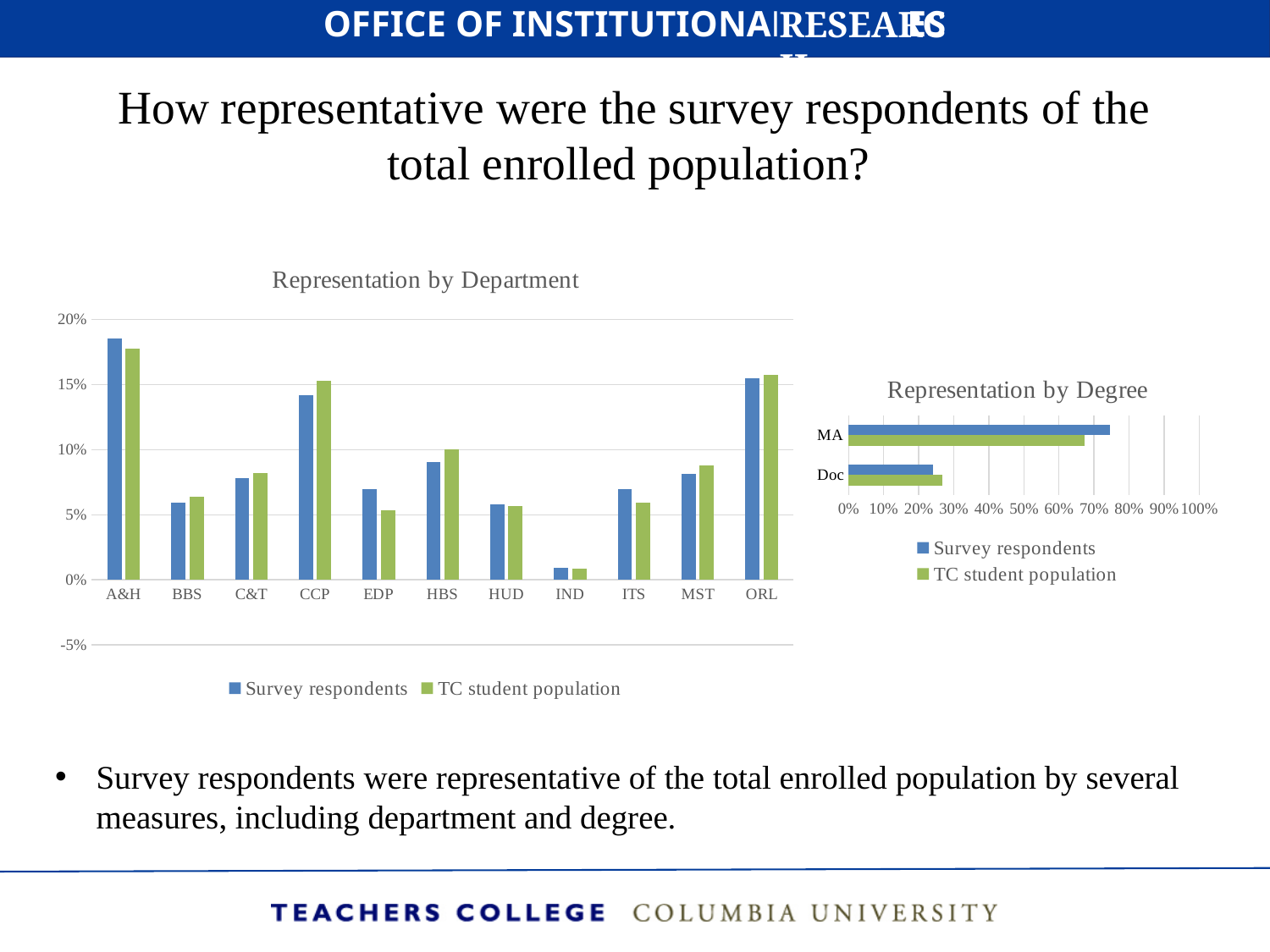
What kind of chart is the "Representation by Department" chart? bar chart In the "Representation by Department" chart, for EDP, which is larger: Survey respondents or TC student population? Survey respondents In the "Representation by Degree" chart, for MA, which is larger: Survey respondents or TC student population? Survey respondents How many series does the legend of the "Representation by Department" chart list? 2 In the "Representation by Department" chart, is the Survey respondents value for A&H greater or less than 15%? greater How many degree categories are shown in the "Representation by Degree" chart? 2 In the "Representation by Department" chart, is the TC student population value for CCP greater or less than 10%? greater How many departments are shown on the x axis of the "Representation by Department" chart? 11 In the "Representation by Degree" chart, is the Survey respondents value for MA greater or less than 50%? greater What kind of chart is the "Representation by Degree" chart? bar chart In the "Representation by Department" chart, which department has the lowest TC student population value? IND In the "Representation by Department" chart, which department has the highest Survey respondents value? A&H